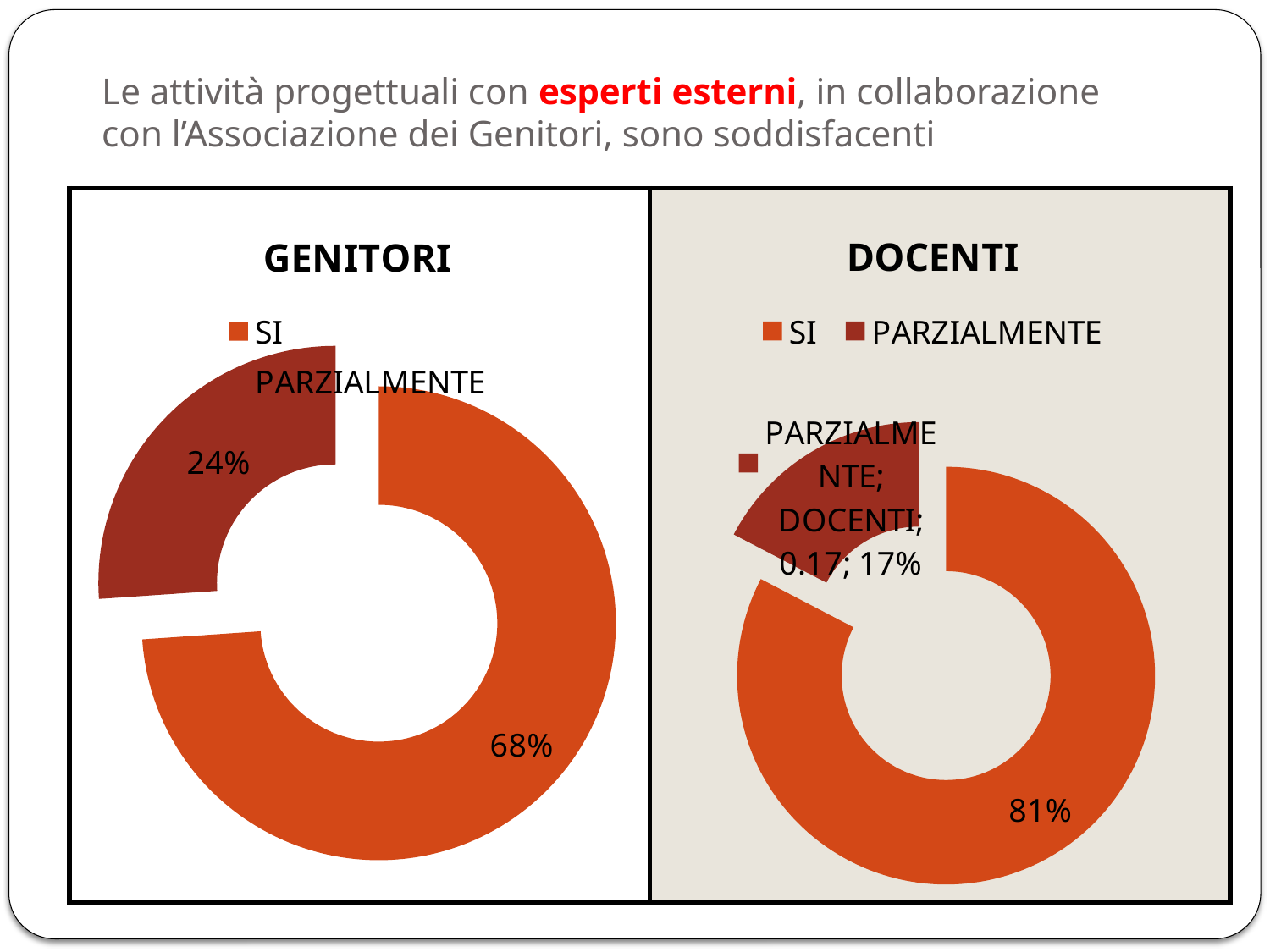
How many entries does the legend of the DOCENTI chart list? 2 In the DOCENTI chart, what is the difference in percentage points between SI and PARZIALMENTE? 64 What is the title of the chart on the right side of the slide? DOCENTI In the GENITORI chart, what is the difference in percentage points between SI and PARZIALMENTE? 44 In the DOCENTI chart, what percentage is shown for SI? 81% In the GENITORI chart, what percentage is shown for SI? 68% In the GENITORI chart, which category has the largest share? SI What kind of chart is the GENITORI chart? Doughnut (pie) chart Is the SI share larger in the GENITORI chart or in the DOCENTI chart? DOCENTI In the DOCENTI chart, which category has the smallest share? PARZIALMENTE In the DOCENTI chart, what percentage is shown for PARZIALMENTE? 17% In the GENITORI chart, what percentage is shown for PARZIALMENTE? 24%